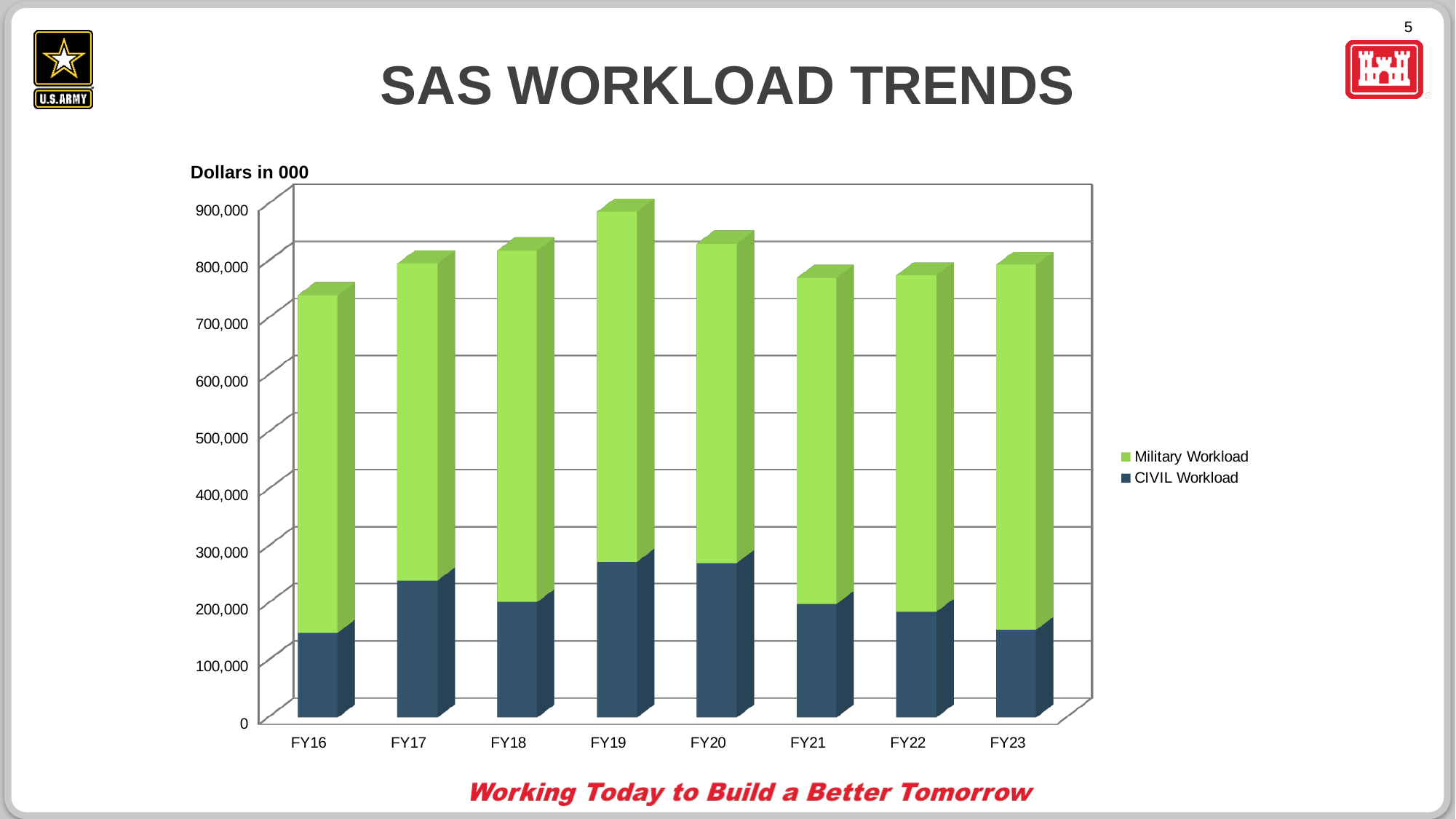
Which series is shown in green in the chart? Military Workload What unit label is shown above the y axis of the chart? Dollars in 000 How many fiscal years are shown on the x axis of the chart? 8 Which fiscal year has the lowest total workload bar? FY16 How many series does the chart legend list? 2 What kind of chart is shown on the slide? bar chart Which is larger, the CIVIL Workload for FY17 or for FY16? FY17 Is the CIVIL Workload value for FY19 greater or less than 200,000? greater Is the total workload for FY19 greater or less than 800,000? greater Is the CIVIL Workload value for FY16 greater or less than 200,000? less Which fiscal year has the highest total workload bar? FY19